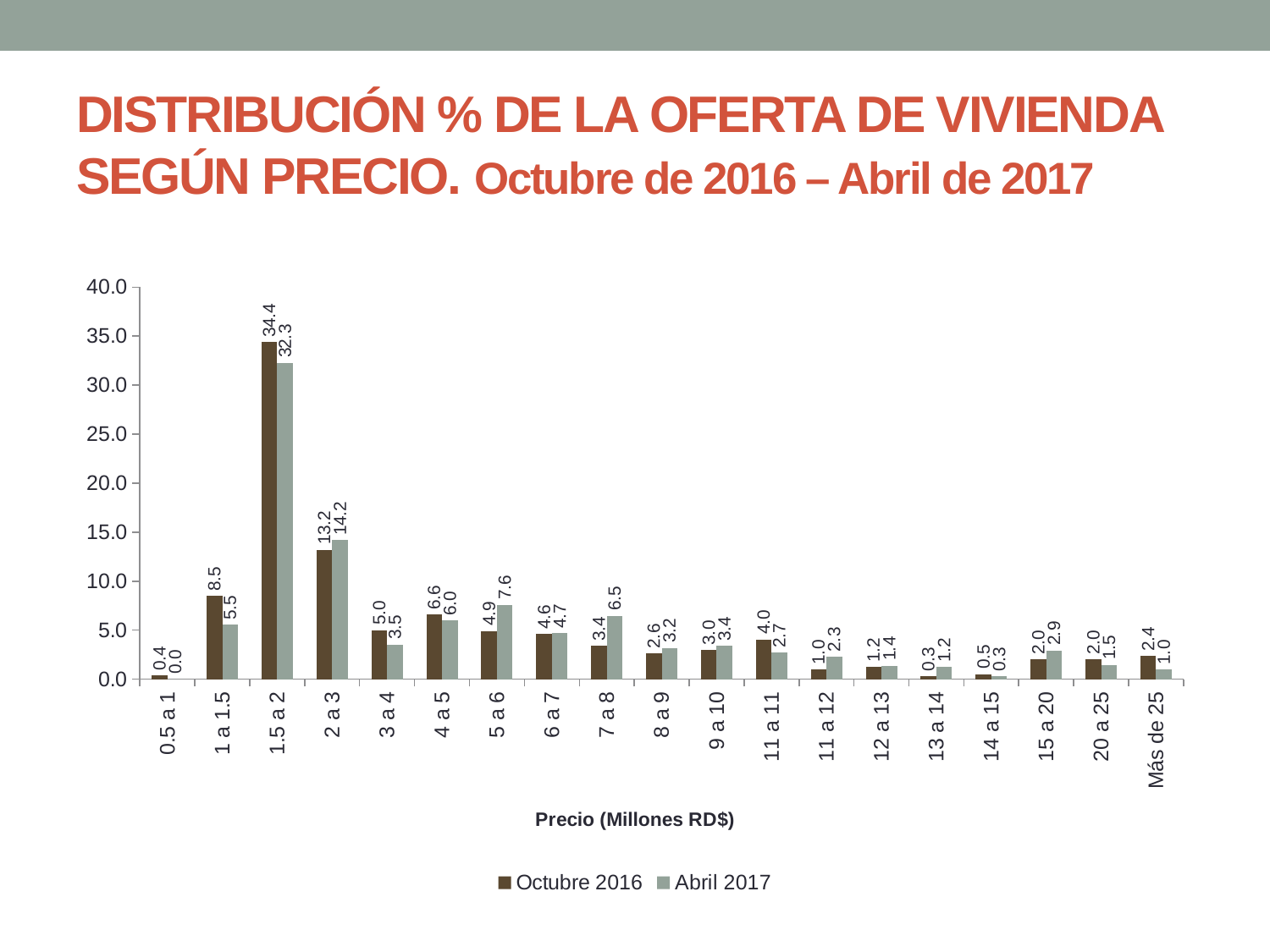
What is the label of the x axis? Precio (Millones RD$) Is the Octubre 2016 value for the 2 a 3 price range greater or less than 10.0? greater What type of chart is shown on the slide? Bar chart How many series does the legend list? 2 What is the Abril 2017 value for the 7 a 8 price range? 6.5 Which price range has the highest Abril 2017 value? 1.5 a 2 Which price range has the lowest Octubre 2016 value? 13 a 14 What is the Abril 2017 value for the 0.5 a 1 price range? 0.0 For the 5 a 6 price range, which series has the larger value, Octubre 2016 or Abril 2017? Abril 2017 How many price ranges are shown on the x axis? 19 What is the difference between the Octubre 2016 and Abril 2017 values for the 1 a 1.5 price range? 3.0 What is the Octubre 2016 value for the 1.5 a 2 price range? 34.4